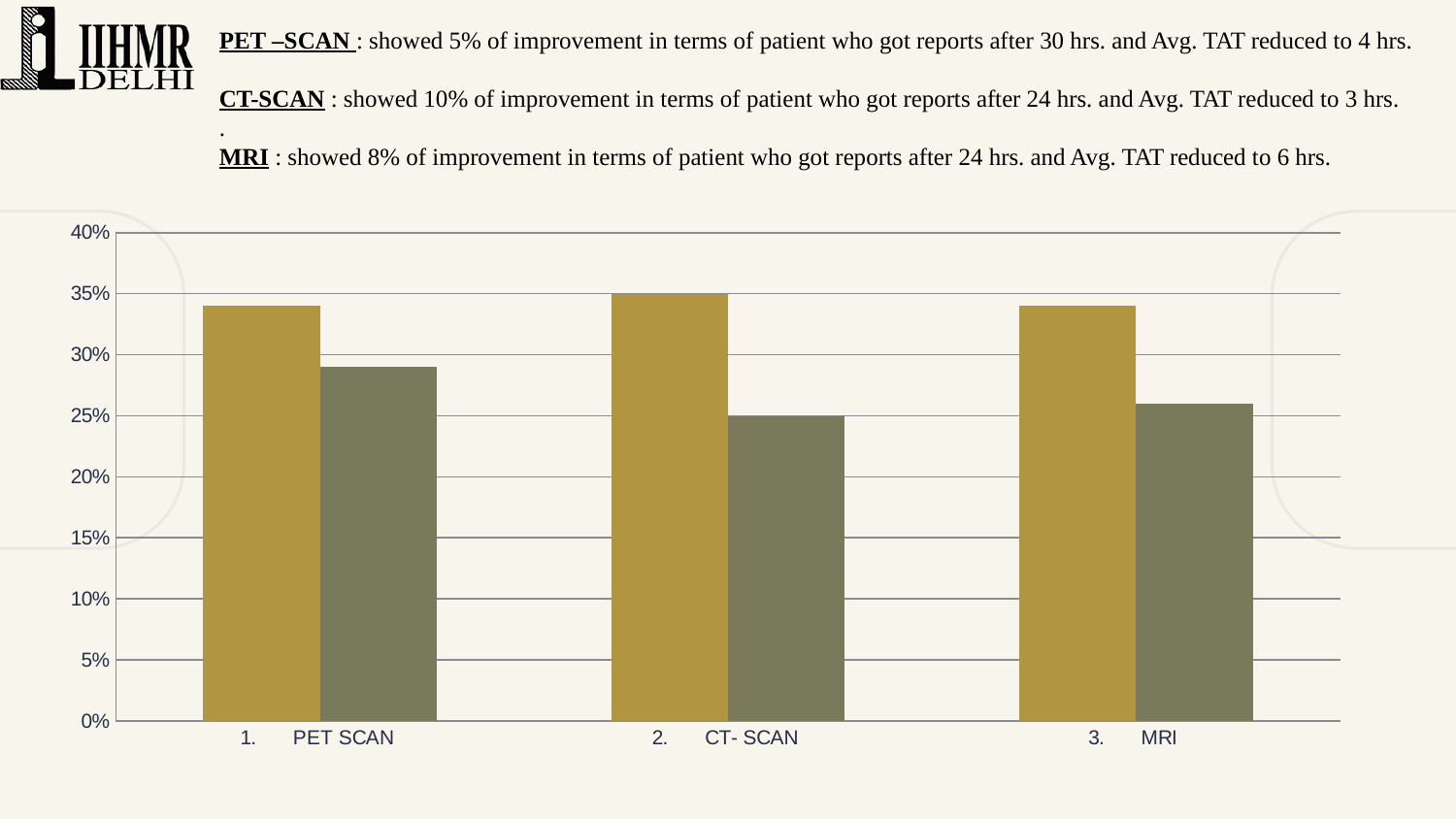
How many categories are shown along the x axis of the chart? 3 Which category has the highest gold bar? CT- SCAN What kind of chart is shown on the slide? bar chart Is the value of the grey-green bar for MRI greater or less than 30%? less What is the difference between the gold bar and the grey-green bar for CT- SCAN? 10% Which category has the lowest grey-green bar? CT- SCAN Is the value of the gold bar for MRI greater or less than 30%? greater What is the value of the grey-green (right) bar for CT- SCAN? 25% Is the value of the grey-green bar for PET SCAN greater or less than 25%? greater For PET SCAN, which bar is taller, the gold bar or the grey-green bar? the gold bar What is the value of the gold (left) bar for CT- SCAN? 35% How many bars are plotted in the chart in total? 6